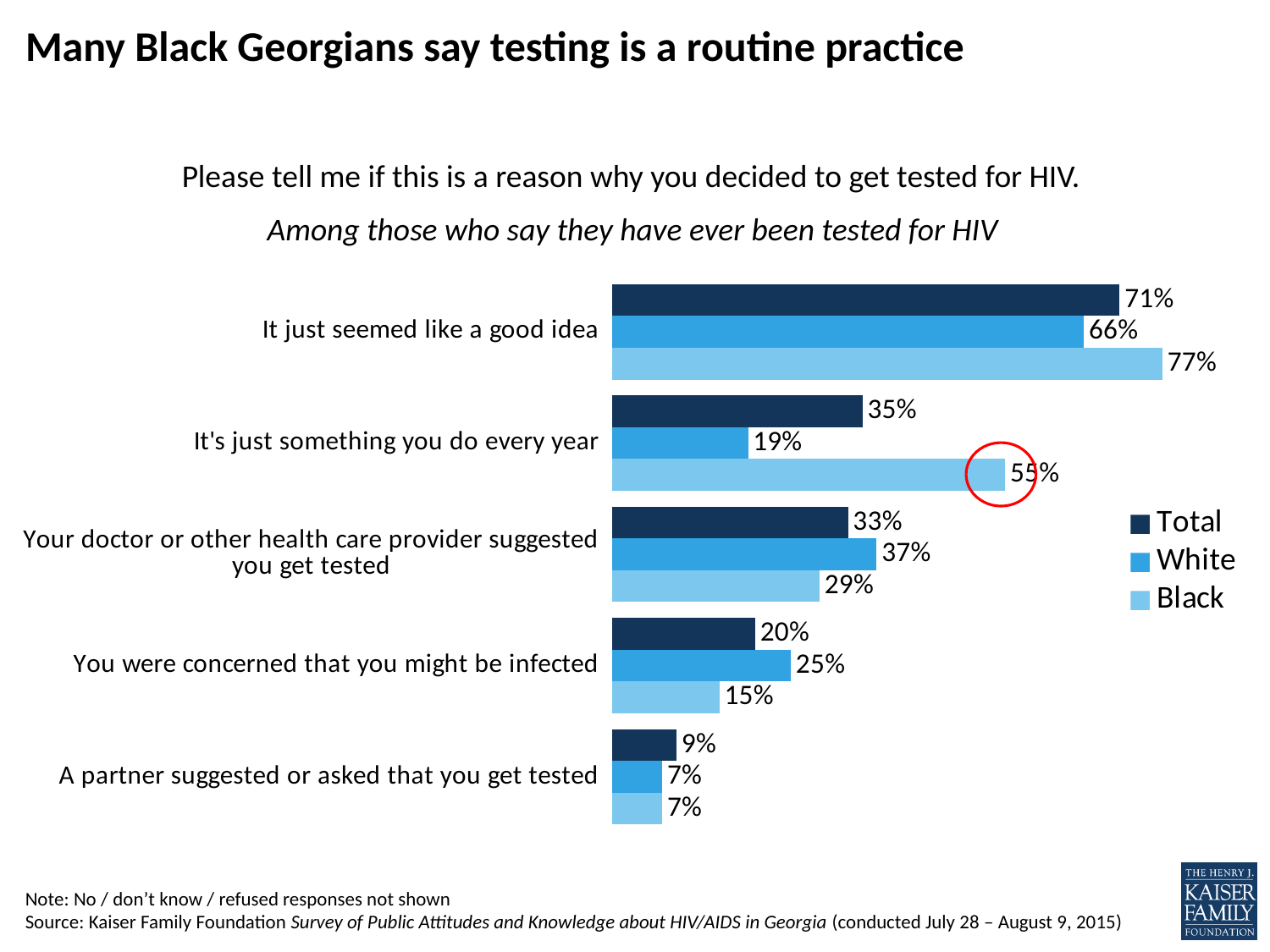
Which series is shown in the darkest blue colour? Total What is the Black value for "You were concerned that you might be infected"? 15% What percentage of Black respondents said "It's just something you do every year" was a reason they got tested? 55% How many reasons (categories) are shown in the chart? 5 What is the Total value for "It just seemed like a good idea"? 71% What is the difference between the Black and White values for "It's just something you do every year"? 36 percentage points What percentage of White respondents said their doctor or other health care provider suggested they get tested? 37% For "You were concerned that you might be infected", is the White value or the Black value larger? White What type of chart is shown on the slide? Bar chart Which reason has the highest value for Black respondents? It just seemed like a good idea How many series does the legend list? 3 Which reason has the lowest Total value? A partner suggested or asked that you get tested